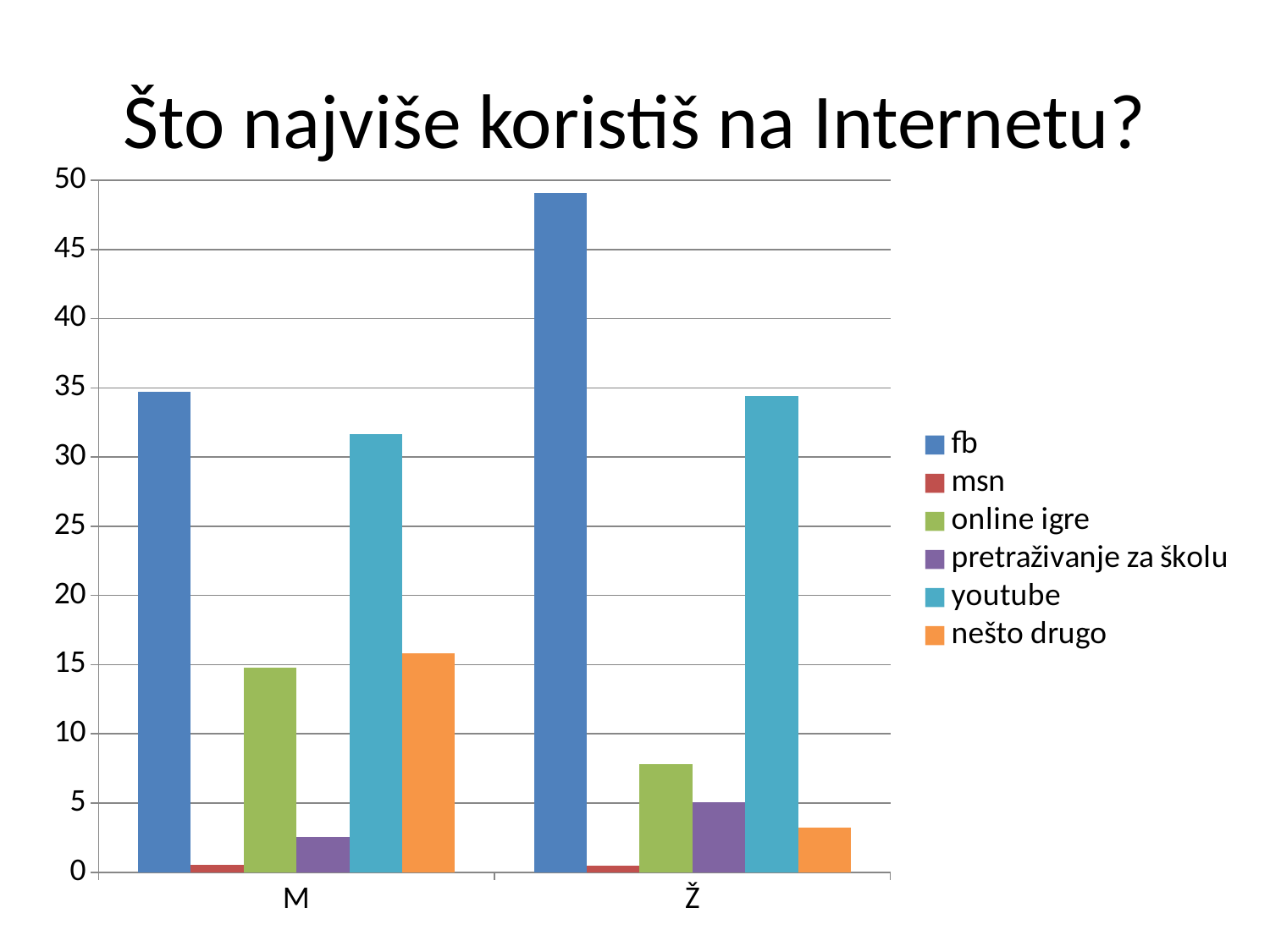
Is the value for fb in the M category greater or less than 30? greater Which category has the larger value for online igre, M or Ž? M Which series has the lowest value for the M category? msn How many series does the legend list? 6 What kind of chart is shown on the slide? bar chart For the M category, which is larger, fb or youtube? fb Is the value for youtube in the Ž category greater or less than 30? greater Is the value for online igre in the Ž category greater or less than 10? less How many categories are shown on the x axis? 2 Which series has the highest value for the Ž category? fb What is the title of the chart? Što najviše koristiš na Internetu?